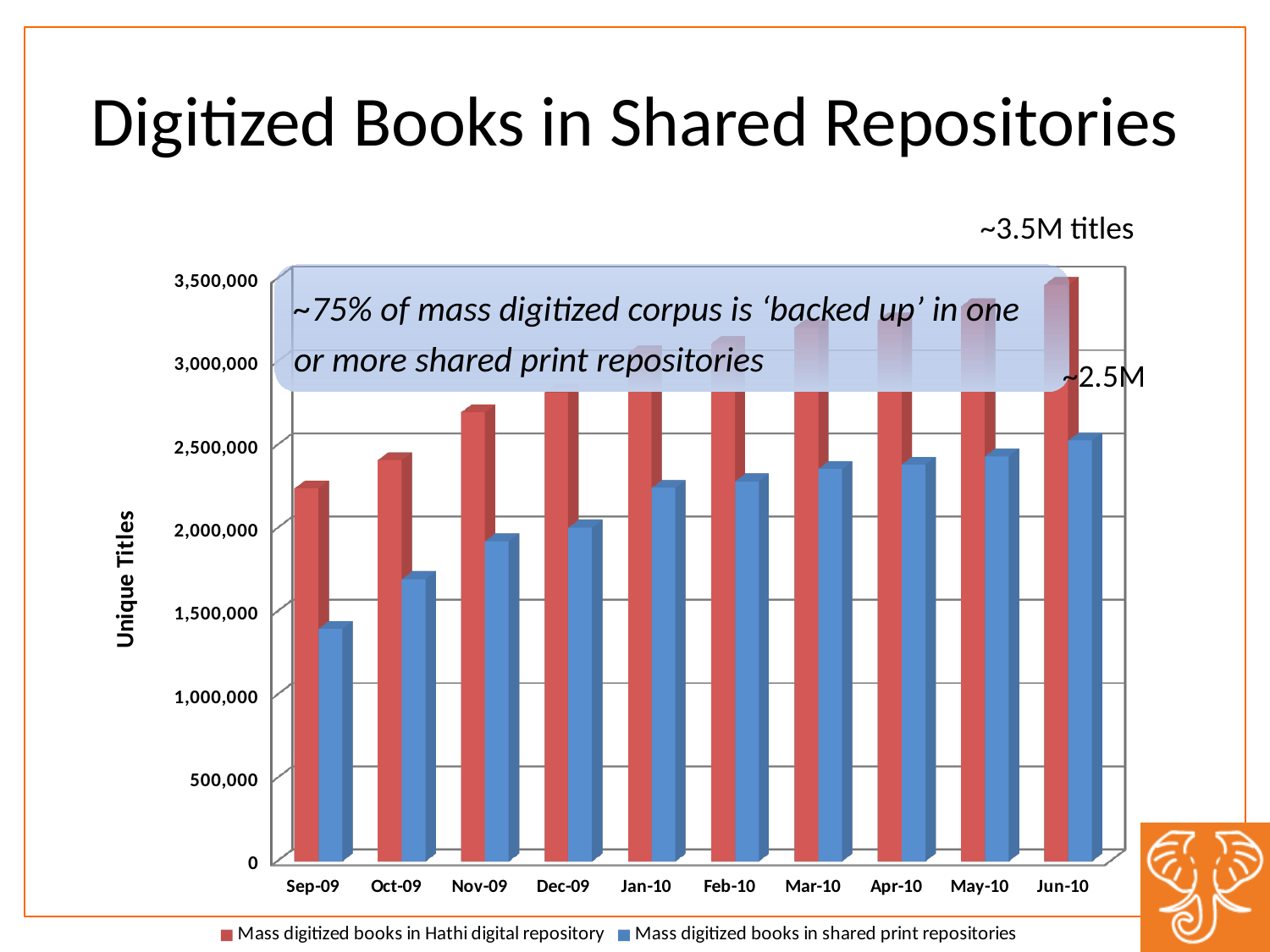
Which colour represents Mass digitized books in Hathi digital repository in the chart? red In which month is the value for Mass digitized books in shared print repositories lowest? Sep-09 Is the value for Mass digitized books in Hathi digital repository in Jun-10 greater or less than 3,000,000? greater In which month is the value for Mass digitized books in Hathi digital repository highest? Jun-10 In Jan-10, which is larger: Mass digitized books in Hathi digital repository or Mass digitized books in shared print repositories? Mass digitized books in Hathi digital repository How many months are shown along the x axis of the chart? 10 How many series does the chart's legend list? 2 Is the value for Mass digitized books in shared print repositories in Sep-09 greater or less than 1,500,000? less Do the values for Mass digitized books in shared print repositories rise or fall from Sep-09 to Jun-10? rise What kind of chart is shown on the slide? bar chart What is the title of the chart's vertical axis? Unique Titles Is the value for Mass digitized books in shared print repositories in Jan-10 greater or less than 2,000,000? greater